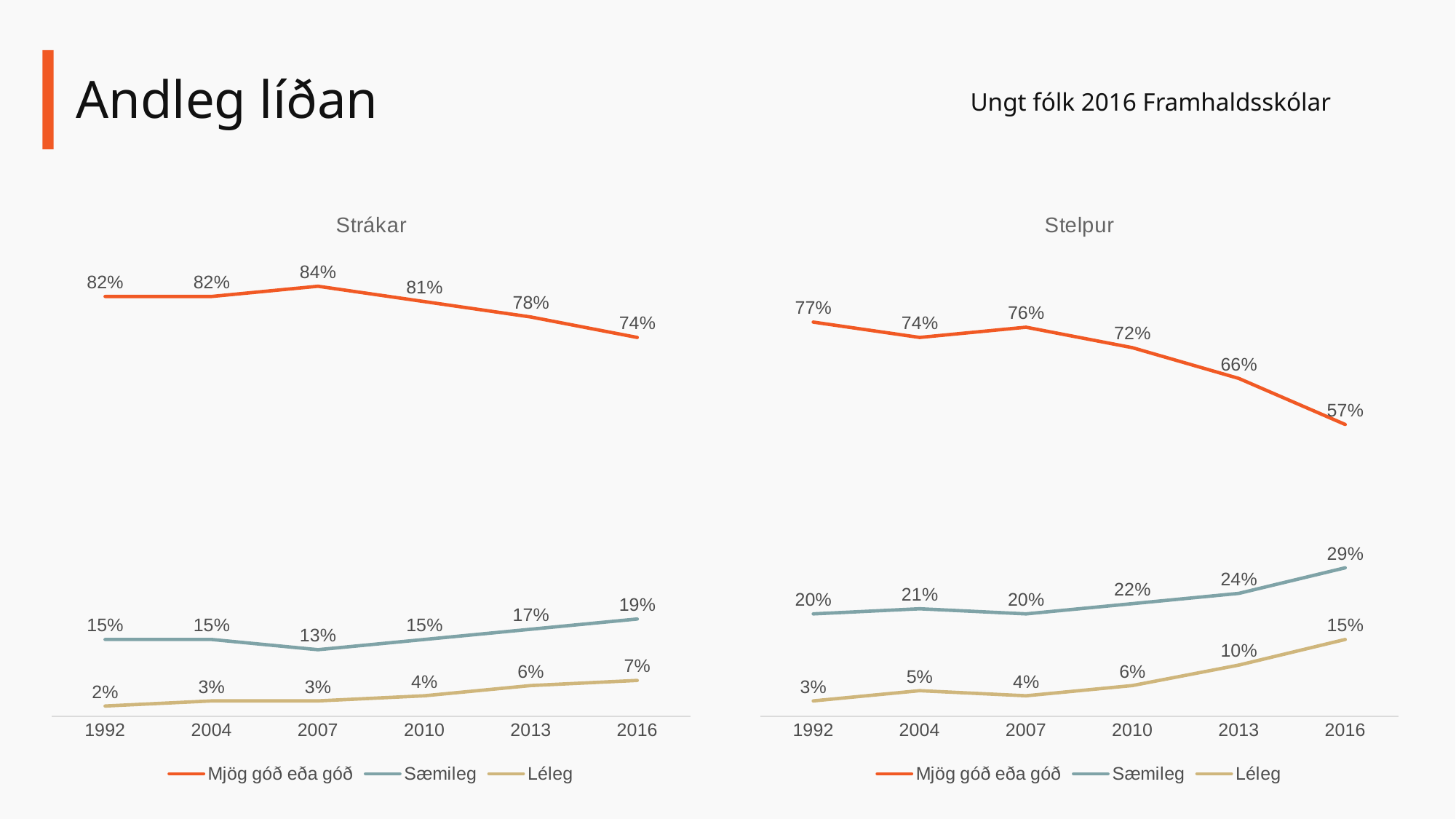
In the Strákar chart, what is the value for Mjög góð eða góð in 2007? 84% Which is larger: the 2016 Léleg value in the Strákar chart or the 2016 Léleg value in the Stelpur chart? Stelpur In the Strákar chart, what is the difference between the Sæmileg values in 2016 and 2007? 6% In the Stelpur chart, does the Sæmileg series rise or fall from 2007 to 2016? Rise How many years are shown on the x axis of the Strákar chart? 6 In the Stelpur chart, what is the value for Léleg in 2013? 10% In the Stelpur chart, in which year is Mjög góð eða góð lowest? 2016 In the Stelpur chart, what is the difference between the Mjög góð eða góð values in 1992 and 2016? 20% How many series does the legend of the Stelpur chart list? 3 In the Strákar chart, in which year is Mjög góð eða góð highest? 2007 In the Stelpur chart, what is the value for Sæmileg in 2016? 29% What kind of chart is the Stelpur chart? Line chart